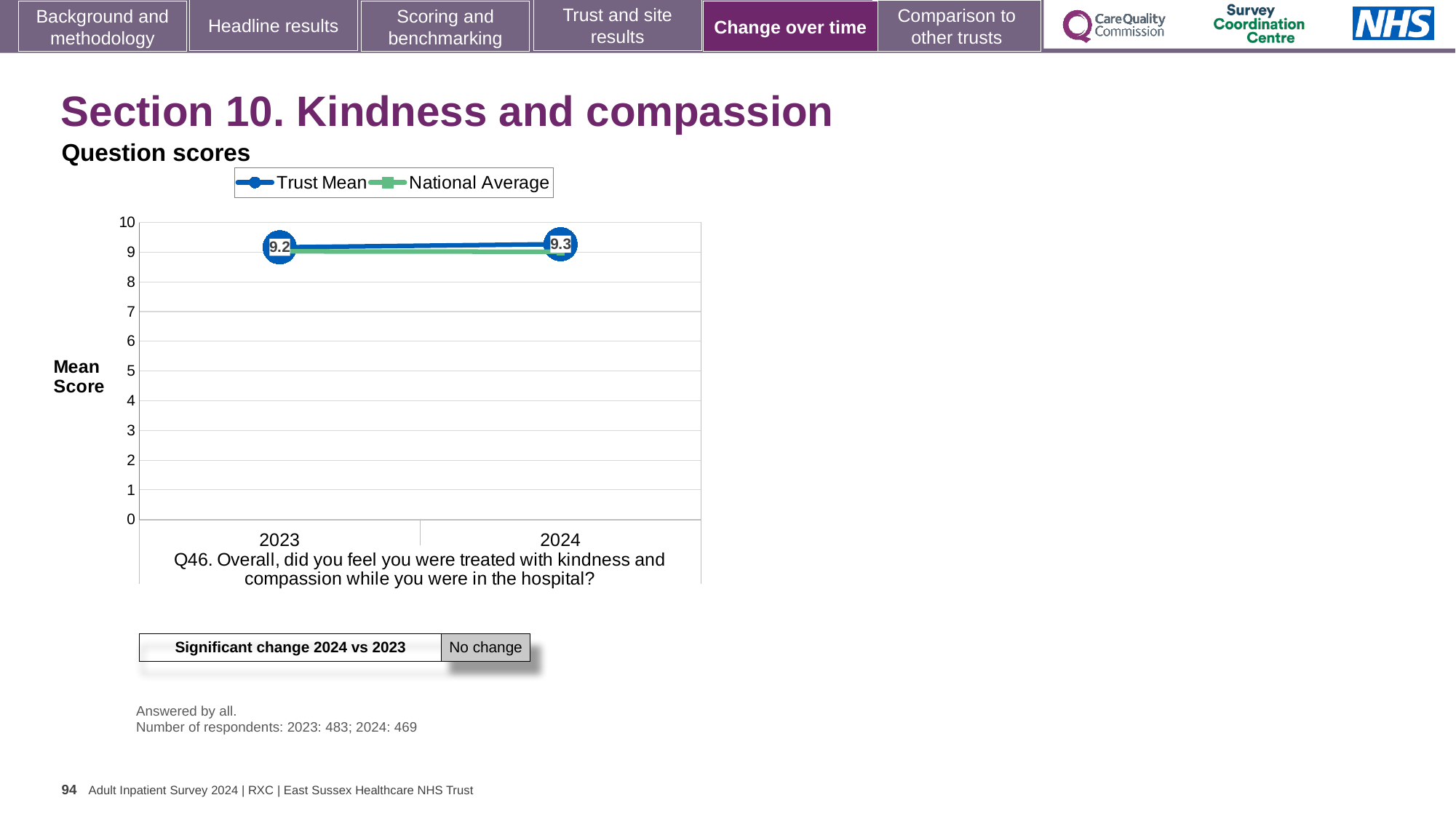
How many series does the chart legend list? 2 How many years are shown on the x axis of the chart? 2 Does the Trust Mean rise or fall from 2023 to 2024? rise Which year has the higher Trust Mean score, 2023 or 2024? 2024 What are the two series named in the chart legend? Trust Mean and National Average What is the Trust Mean score for 2023? 9.2 Is the Trust Mean value for 2023 greater or less than 5? greater What is the label on the y axis of the chart? Mean Score By how much did the Trust Mean change from 2023 to 2024? 0.1 Is the National Average value for 2024 greater or less than 8? greater What kind of chart is shown on the slide? line chart What is the Trust Mean score for 2024? 9.3